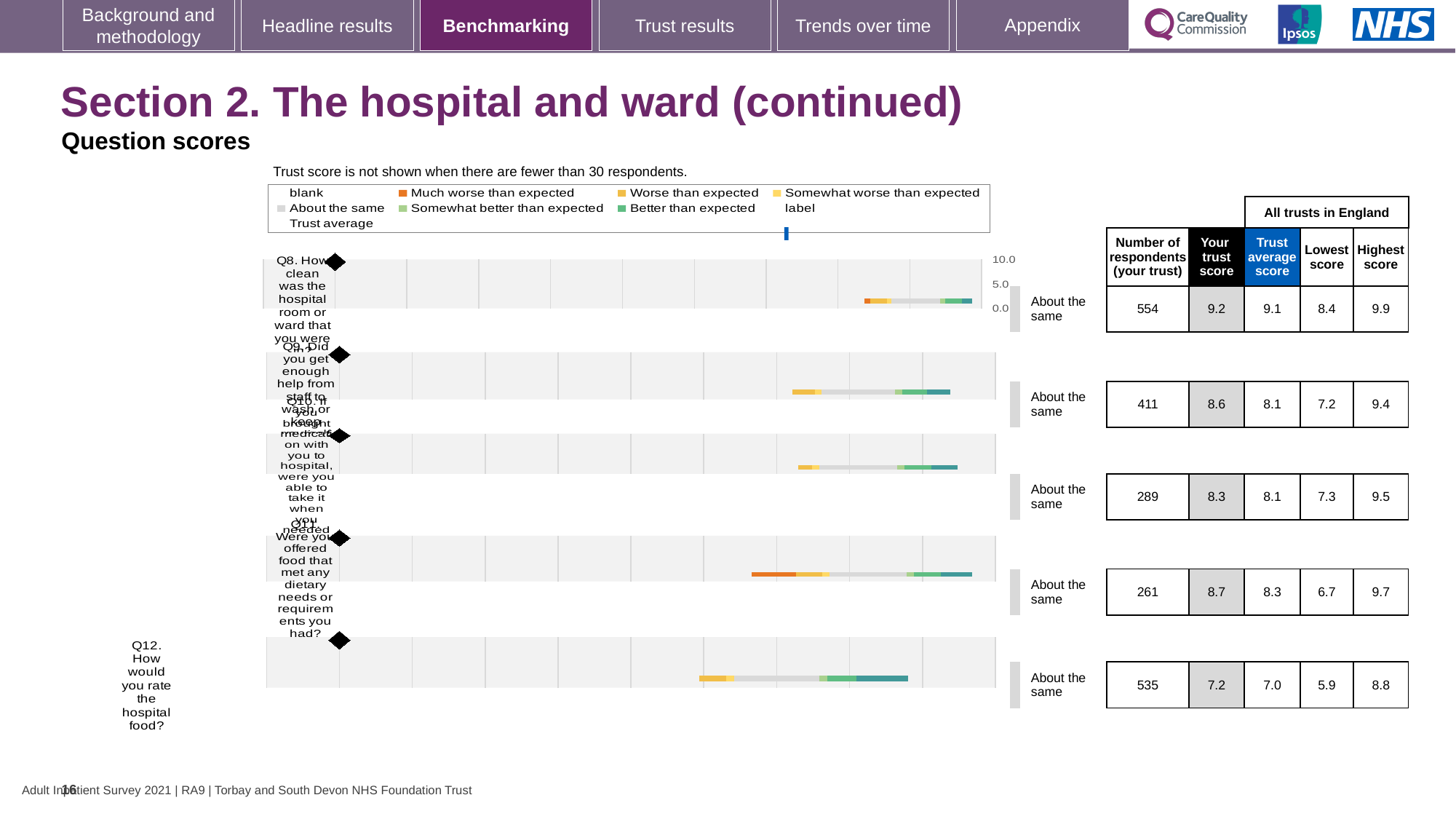
For Q12 (how would you rate the hospital food), what is the difference between the highest score and the lowest score across all trusts in England? 2.9 How many questions (Q8 to Q12) are plotted in the chart? 5 Which question has the lowest 'Your trust score'? Q12 How many respondents from your trust answered Q10 (medication brought with you to hospital)? 289 What is the 'Your trust score' for Q8 (how clean was the hospital room or ward)? 9.2 What benchmark category is shown for Q12 (how would you rate the hospital food)? About the same What is the lowest score across all trusts in England for Q11 (food that met dietary needs)? 6.7 What kind of chart is used to show the question scores on this slide? bar chart For Q9 (enough help from staff to wash or keep clean), which is larger: your trust score or the trust average score? Your trust score For Q8, how much higher is your trust score than the trust average score? 0.1 Which question has the highest 'Your trust score'? Q8 What is the trust average score for Q12 (how would you rate the hospital food)? 7.0